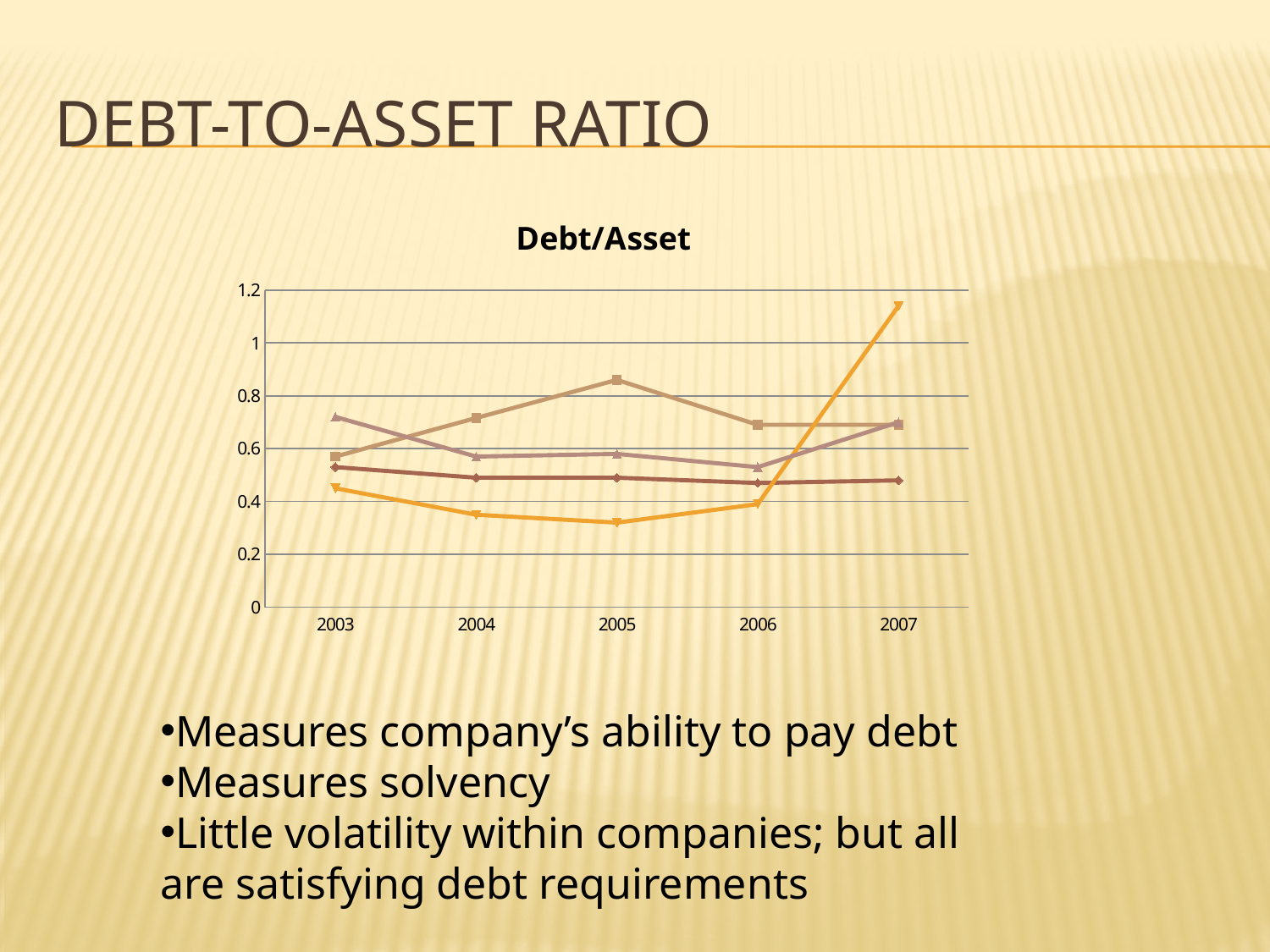
What is the title of the chart? Debt/Asset Is the value of the orange line in 2005 greater or less than 0.4? less Which line reaches the highest point on the chart? the orange line, in 2007 Is the value of the orange line in 2007 greater or less than 1? greater How many years are shown on the x axis of the chart? 5 In which year does the orange line reach its highest value? 2007 Does the line with square markers rise or fall between 2005 and 2006? fall Is the value of the line with square markers in 2005 greater or less than 0.8? greater How many lines are plotted on the chart? 4 What kind of chart is shown on the slide? line chart Does the orange line rise or fall between 2006 and 2007? rise